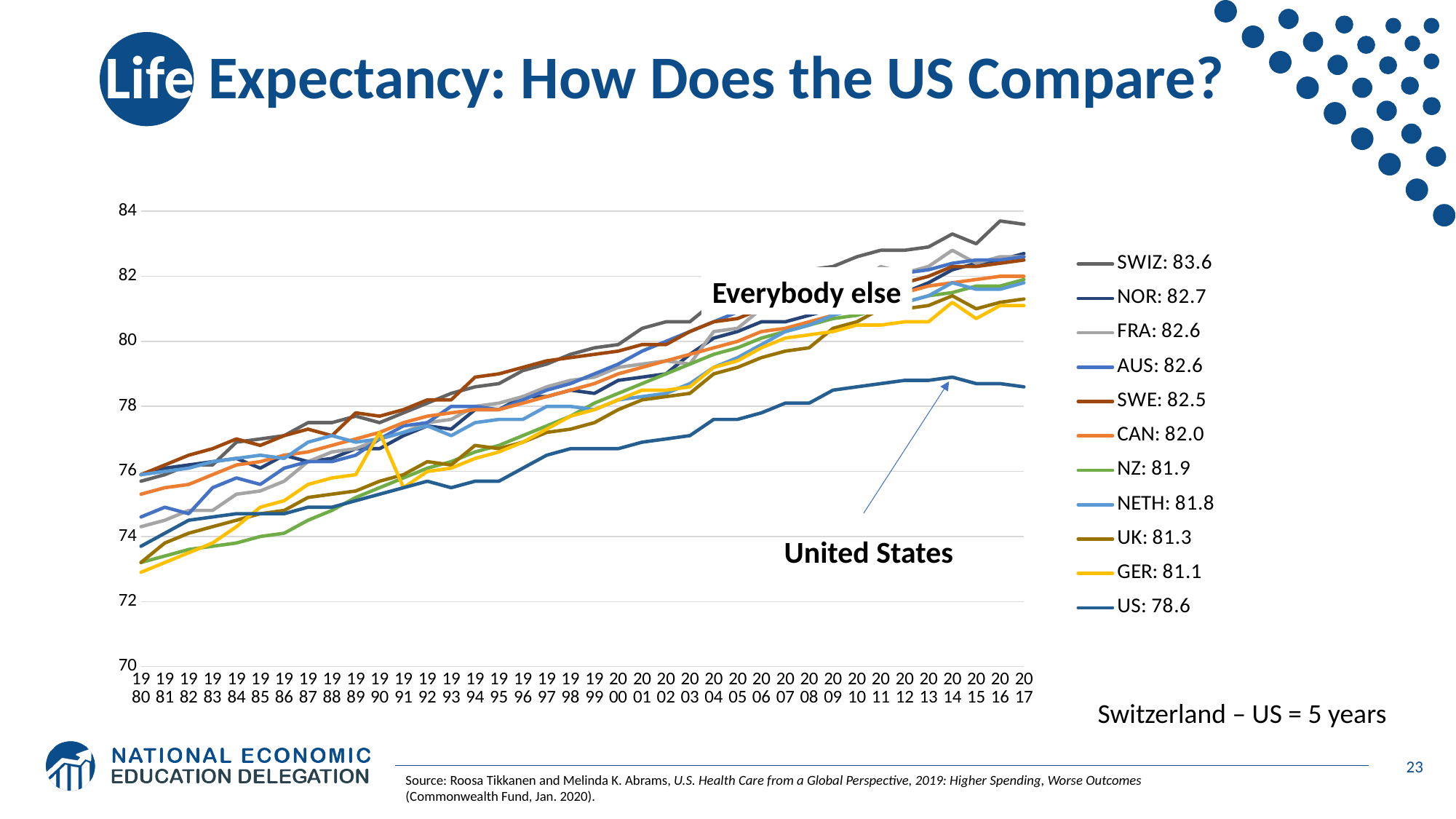
How many series does the legend list? 11 Is the value for the US in 2010 greater or less than 78? greater According to the legend, what is the life expectancy value for SWIZ? 83.6 According to the legend, what is the life expectancy value for the US? 78.6 How many years are plotted along the x axis? 38 Which country has the highest life expectancy value in the legend? SWIZ According to the legend, what is the life expectancy value for GER? 81.1 What is the difference between the legend values for SWIZ and the US? 5 Which has the larger legend value, CAN or UK? CAN What kind of chart is shown on the slide? line chart Which country has the lowest life expectancy value in the legend? US Do the life expectancy lines generally rise or fall from 1980 to 2017? rise